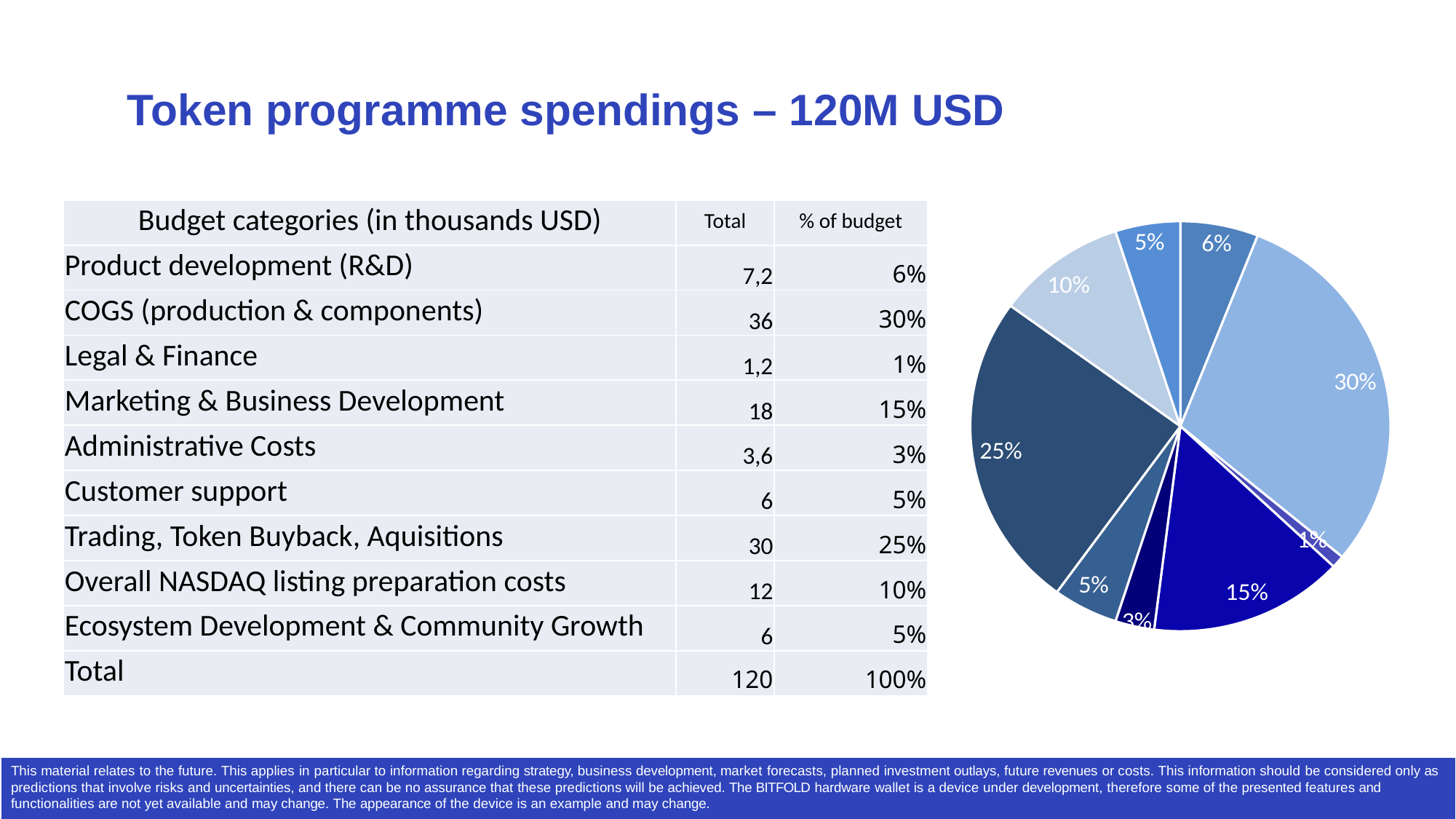
Which budget category corresponds to the smallest slice of the pie chart? Legal & Finance What kind of chart is shown on the right of the slide? pie chart What share of the budget does Trading, Token Buyback, Aquisitions account for? 25% Which is larger: the slice for Overall NASDAQ listing preparation costs or the slice for Product development (R&D)? Overall NASDAQ listing preparation costs How many slices does the pie chart have? 9 What is the percentage shown on the smallest slice of the pie chart? 1% Which budget category corresponds to the largest slice of the pie chart? COGS (production & components) What share of the budget does Marketing & Business Development account for? 15% How many slices of the pie chart are labelled 5%? 2 What is the percentage shown on the largest slice of the pie chart? 30% What is the difference in percentage points between the 30% slice and the 25% slice? 5 What is the title of the slide containing the pie chart? Token programme spendings – 120M USD